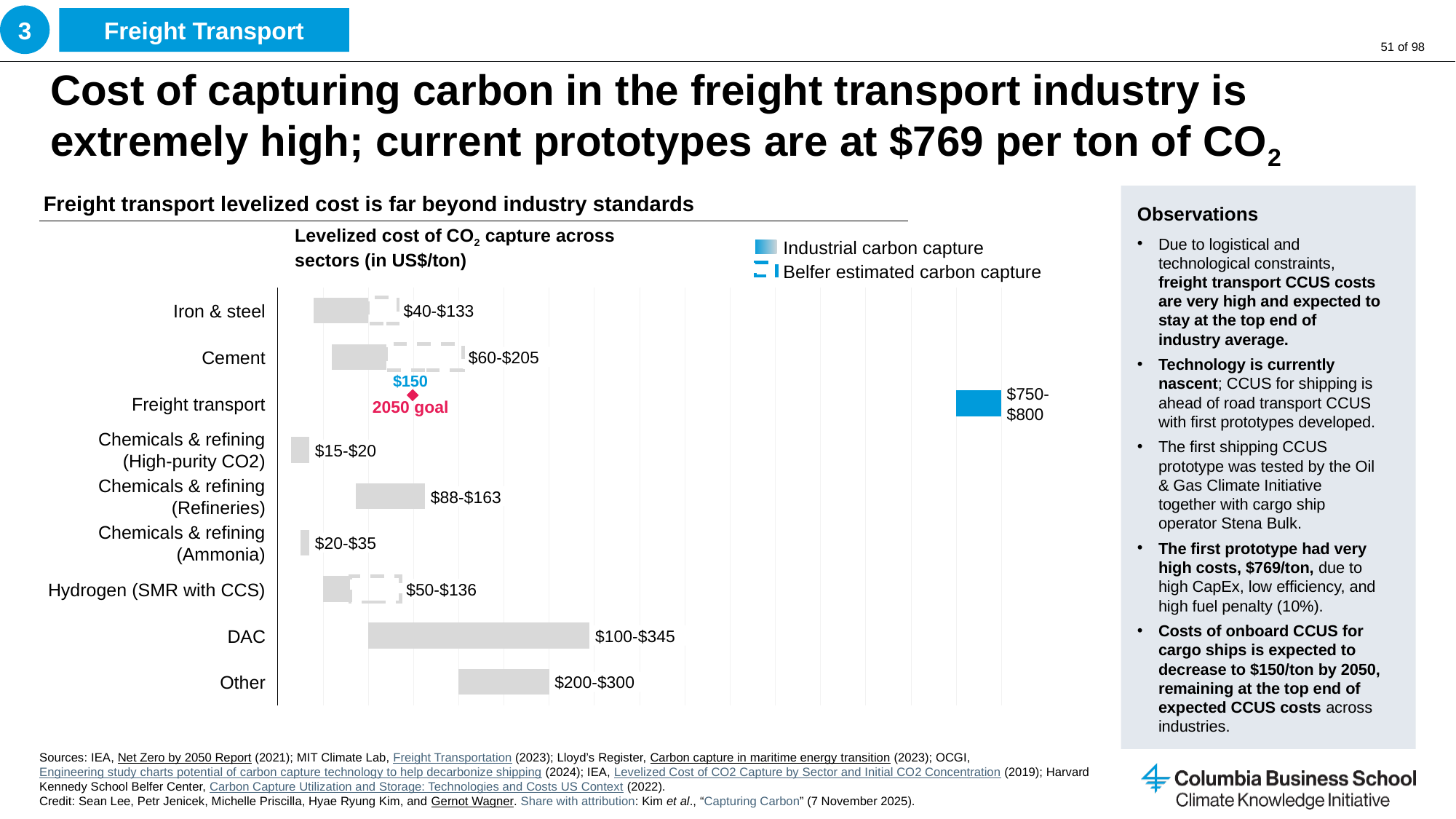
How many sectors are listed on the chart? 9 Which sector has the lowest levelized cost of CO2 capture? Chemicals & refining (High-purity CO2) What type of chart is used to show the levelized cost of CO2 capture across sectors? Bar chart What cost range is shown for DAC? $100-$345 What is the difference between the upper end of the Freight transport range ($800) and the upper end of the DAC range ($345)? $455 What is the 2050 goal value marked for Freight transport? $150 Which has a higher upper-end cost, Cement or Iron & steel? Cement What cost range is shown for Freight transport? $750-$800 What cost range is shown for Cement? $60-$205 Which sector has the highest levelized cost of CO2 capture? Freight transport How many entries does the chart legend list? 2 What cost range is shown for Hydrogen (SMR with CCS)? $50-$136